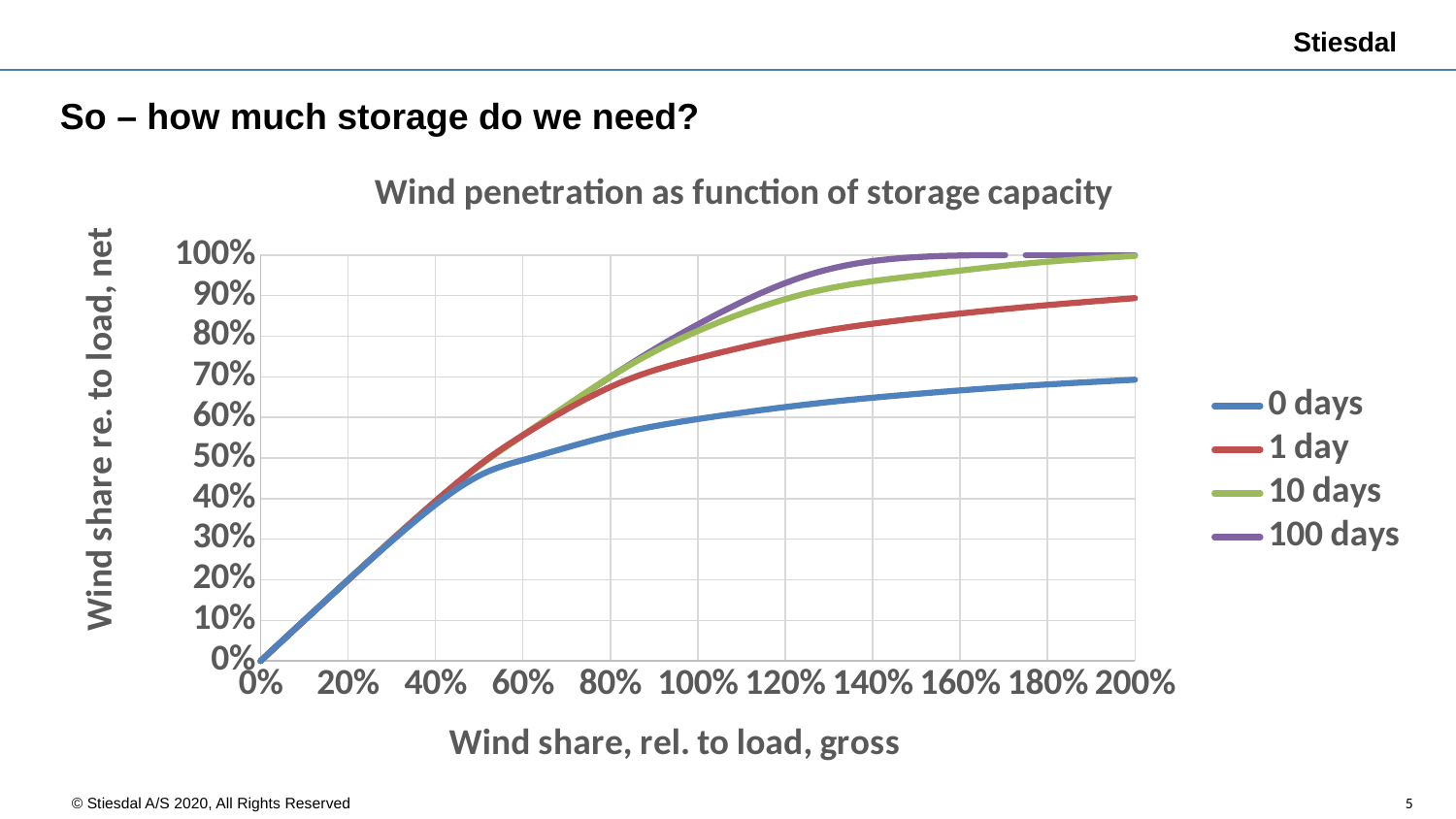
What is the label of the x axis? Wind share, rel. to load, gross Is the value for the 1 day series at a gross wind share of 200% greater or less than 80%? greater Is the value for the 0 days series at a gross wind share of 200% greater or less than 60%? greater Which series has the lowest value at a gross wind share of 200%? 0 days Does the 0 days series rise or fall as the gross wind share increases along the x axis? rise Is the value for the 100 days series at a gross wind share of 120% greater or less than 90%? greater At a gross wind share of 200%, which is larger: the 1 day series or the 0 days series? 1 day What is the title of the chart? Wind penetration as function of storage capacity At a gross wind share of 200%, which is larger: the 100 days series or the 1 day series? 100 days What kind of chart is shown on the slide? line chart How many series does the legend list? 4